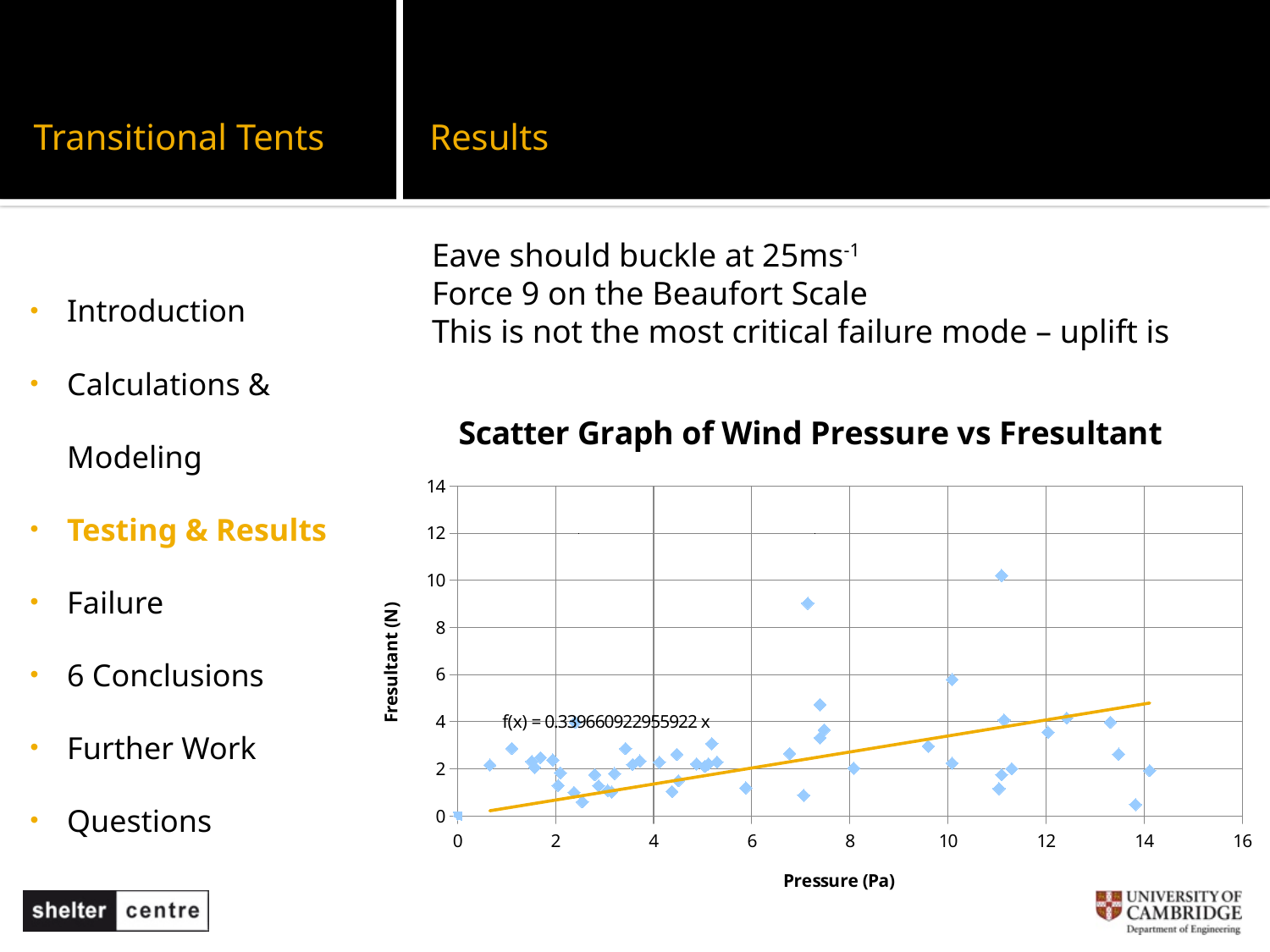
Is the Fresultant value of the highest plotted point greater or less than 8? greater What is the title of the chart? Scatter Graph of Wind Pressure vs Fresultant Does the trendline rise or fall as Pressure increases along the x axis? rises What equation is printed for the trendline on the chart? f(x) = 0.339660922955922 x What kind of chart is shown on the slide? scatter chart What is the slope of the trendline shown on the chart? 0.339660922955922 Is the Fresultant value of the highest point plotted near a Pressure of 7 greater or less than 8? greater Is the trendline value at a Pressure of 14 greater or less than 6? less What is the label on the x axis of the chart? Pressure (Pa)